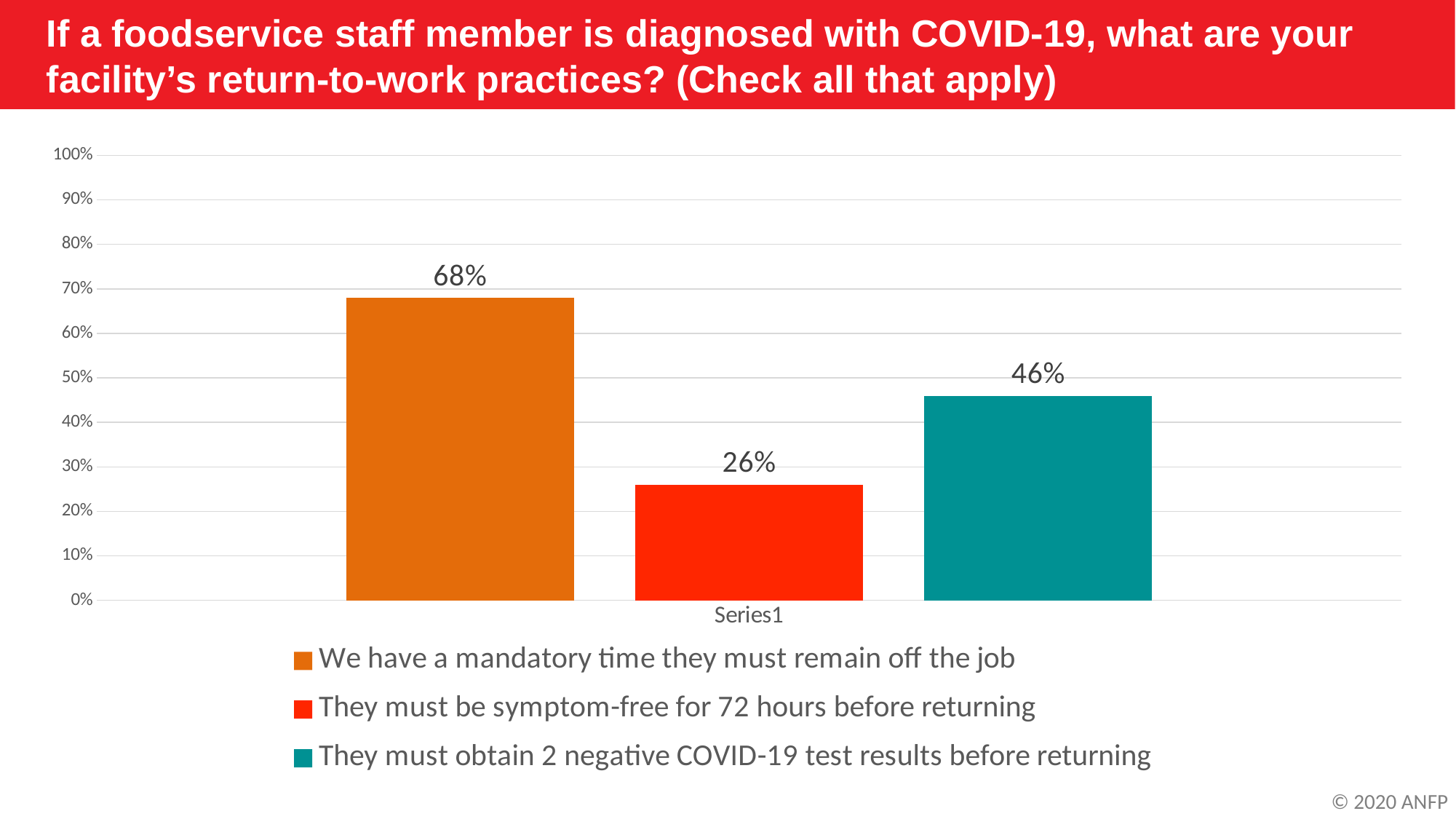
What colour is the bar for the practice requiring 2 negative COVID-19 test results? Teal Is the value for the mandatory time off the job practice greater or less than 60%? greater Which is larger: the percentage for requiring 2 negative COVID-19 test results or the percentage for being symptom-free for 72 hours? They must obtain 2 negative COVID-19 test results before returning Which return-to-work practice has the lowest percentage? They must be symptom-free for 72 hours before returning Which return-to-work practice has the highest percentage? We have a mandatory time they must remain off the job What percentage of respondents said staff must be symptom-free for 72 hours before returning? 26% What is the difference in percentage points between the 2 negative test results practice and the symptom-free for 72 hours practice? 20 How many bars are plotted on the chart? 3 What is the difference in percentage points between the mandatory time off the job practice and the 2 negative test results practice? 22 What percentage of respondents said staff must obtain 2 negative COVID-19 test results before returning? 46% What kind of chart is shown on the slide? Bar chart What percentage of respondents said they have a mandatory time staff must remain off the job? 68%